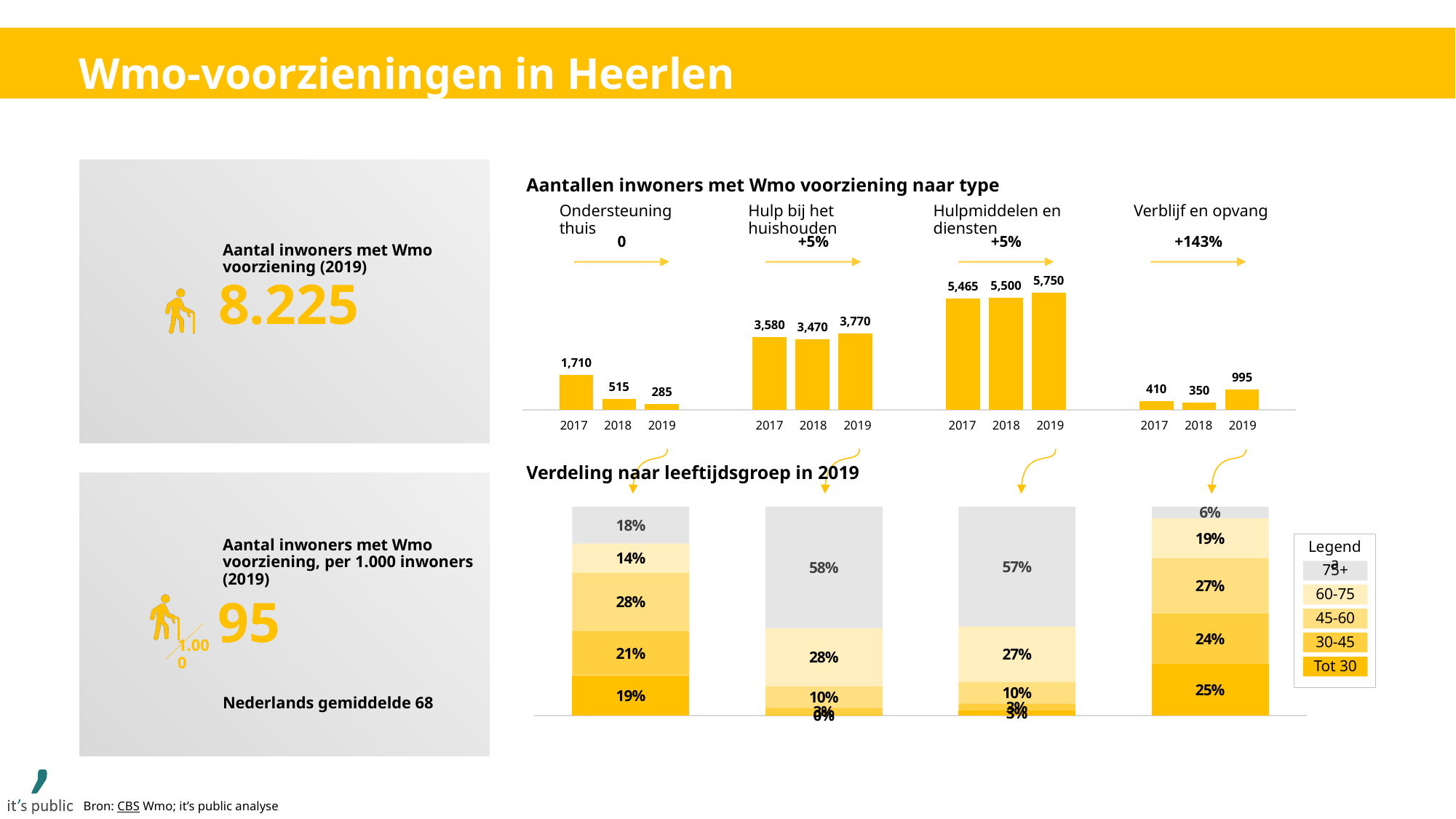
In the chart 'Aantallen inwoners met Wmo voorziening naar type', which year has the highest value for Verblijf en opvang? 2019 In the chart 'Aantallen inwoners met Wmo voorziening naar type', what is the value for Ondersteuning thuis in 2017? 1,710 What kind of chart is 'Aantallen inwoners met Wmo voorziening naar type'? bar chart How many age groups does the legend of the chart 'Verdeling naar leeftijdsgroep in 2019' list? 5 In the chart 'Aantallen inwoners met Wmo voorziening naar type', what is the difference between the 2019 and 2017 values for Hulpmiddelen en diensten? 285 In the chart 'Aantallen inwoners met Wmo voorziening naar type', what is the value for Hulp bij het huishouden in 2018? 3,470 In the chart 'Aantallen inwoners met Wmo voorziening naar type', which year has the lowest value for Hulp bij het huishouden? 2018 In the chart 'Verdeling naar leeftijdsgroep in 2019', what is the share of the 45-60 age group for Ondersteuning thuis? 28% In the chart 'Verdeling naar leeftijdsgroep in 2019', what is the share of the 75+ age group for Verblijf en opvang? 6% In the chart 'Aantallen inwoners met Wmo voorziening naar type', what is the value for Hulpmiddelen en diensten in 2019? 5,750 In the chart 'Aantallen inwoners met Wmo voorziening naar type', do the values for Ondersteuning thuis rise or fall from 2017 to 2019? fall In the chart 'Aantallen inwoners met Wmo voorziening naar type', which is larger in 2018: Ondersteuning thuis or Verblijf en opvang? Ondersteuning thuis